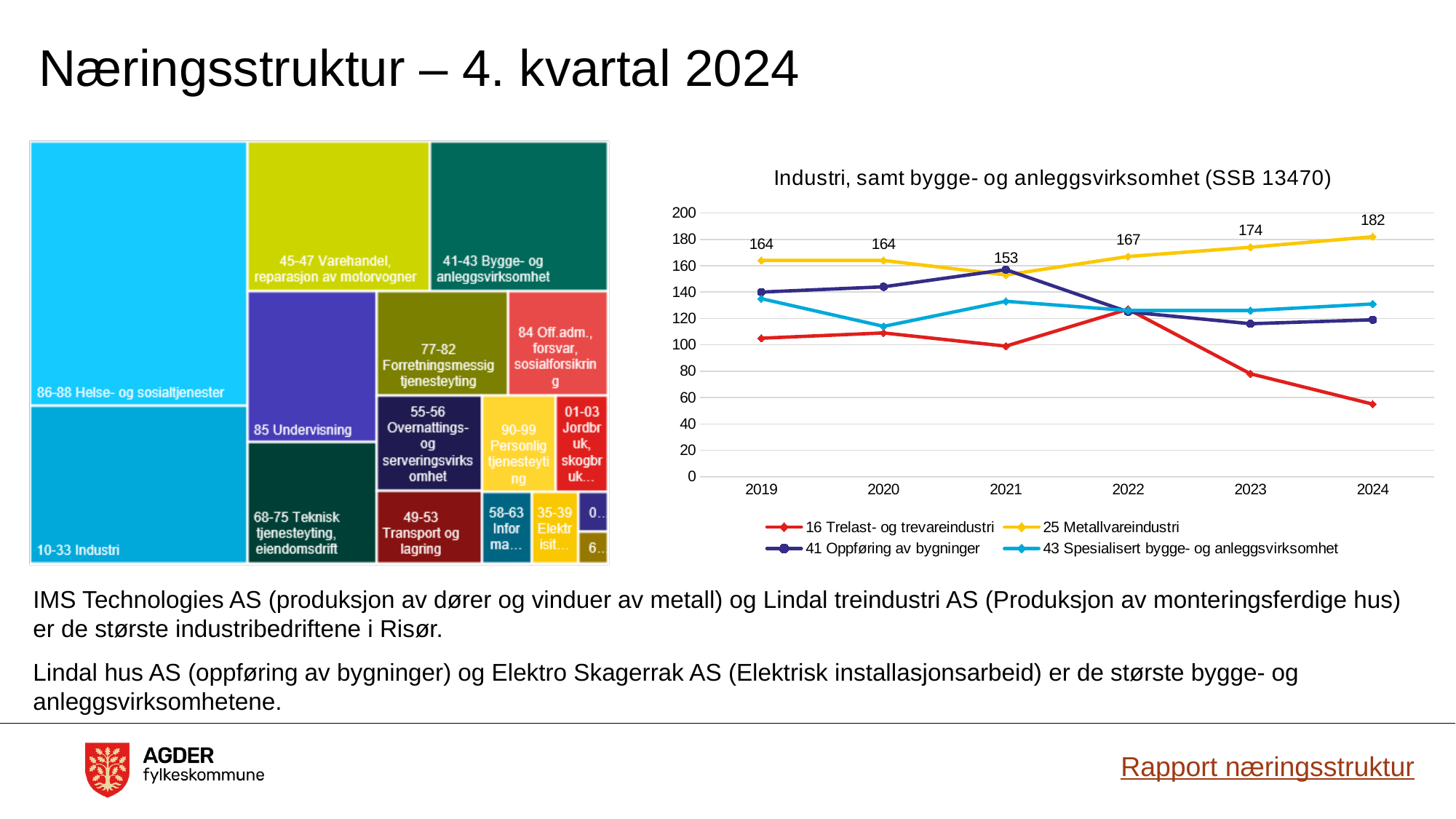
In the chart 'Industri, samt bygge- og anleggsvirksomhet (SSB 13470)', is the value for 41 Oppføring av bygninger in 2019 greater or less than 120? greater What kind of chart is the chart on the left of the slide? treemap In the chart 'Industri, samt bygge- og anleggsvirksomhet (SSB 13470)', how many series does the legend list? 4 In the chart 'Industri, samt bygge- og anleggsvirksomhet (SSB 13470)', does the value for 16 Trelast- og trevareindustri rise or fall from 2022 to 2024? fall In the chart 'Industri, samt bygge- og anleggsvirksomhet (SSB 13470)', what is the value for 25 Metallvareindustri in 2024? 182 In the chart 'Industri, samt bygge- og anleggsvirksomhet (SSB 13470)', what is the difference between the 25 Metallvareindustri values for 2024 and 2023? 8 In the chart 'Industri, samt bygge- og anleggsvirksomhet (SSB 13470)', is the value for 16 Trelast- og trevareindustri in 2024 greater or less than 60? less In the chart 'Industri, samt bygge- og anleggsvirksomhet (SSB 13470)', in which year is 25 Metallvareindustri highest? 2024 In the chart 'Industri, samt bygge- og anleggsvirksomhet (SSB 13470)', how many years are shown on the x axis? 6 In the chart 'Industri, samt bygge- og anleggsvirksomhet (SSB 13470)', which series has the higher value in 2024: 25 Metallvareindustri or 16 Trelast- og trevareindustri? 25 Metallvareindustri In the chart 'Industri, samt bygge- og anleggsvirksomhet (SSB 13470)', what is the value for 25 Metallvareindustri in 2019? 164 What kind of chart is the chart on the right titled 'Industri, samt bygge- og anleggsvirksomhet (SSB 13470)'? line chart